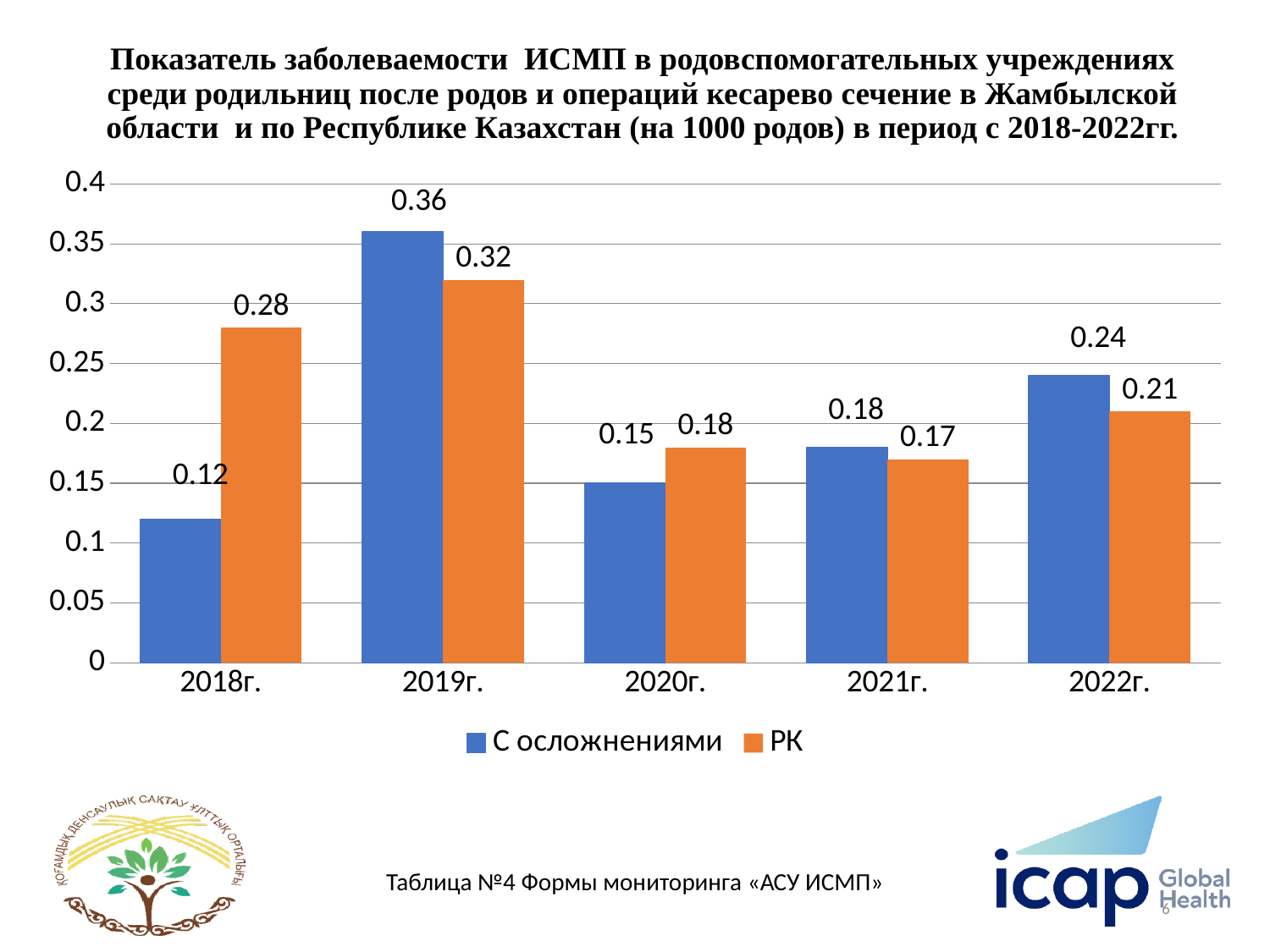
In which year is the "РК" value the highest? 2019г. How many series does the legend list? 2 What is the value for "РК" in 2018г.? 0.28 Is the value for "С осложнениями" in 2020г. greater or less than 0.2? less What kind of chart is shown on the slide? bar chart Which series has the larger value in 2021г., "С осложнениями" or "РК"? С осложнениями Which colour represents the "РК" series? orange How many years are shown on the x axis? 5 What is the difference between the "С осложнениями" and "РК" values in 2018г.? 0.16 In which year is the "С осложнениями" value the lowest? 2018г. What is the value for "РК" in 2022г.? 0.21 What is the value for "С осложнениями" in 2019г.? 0.36